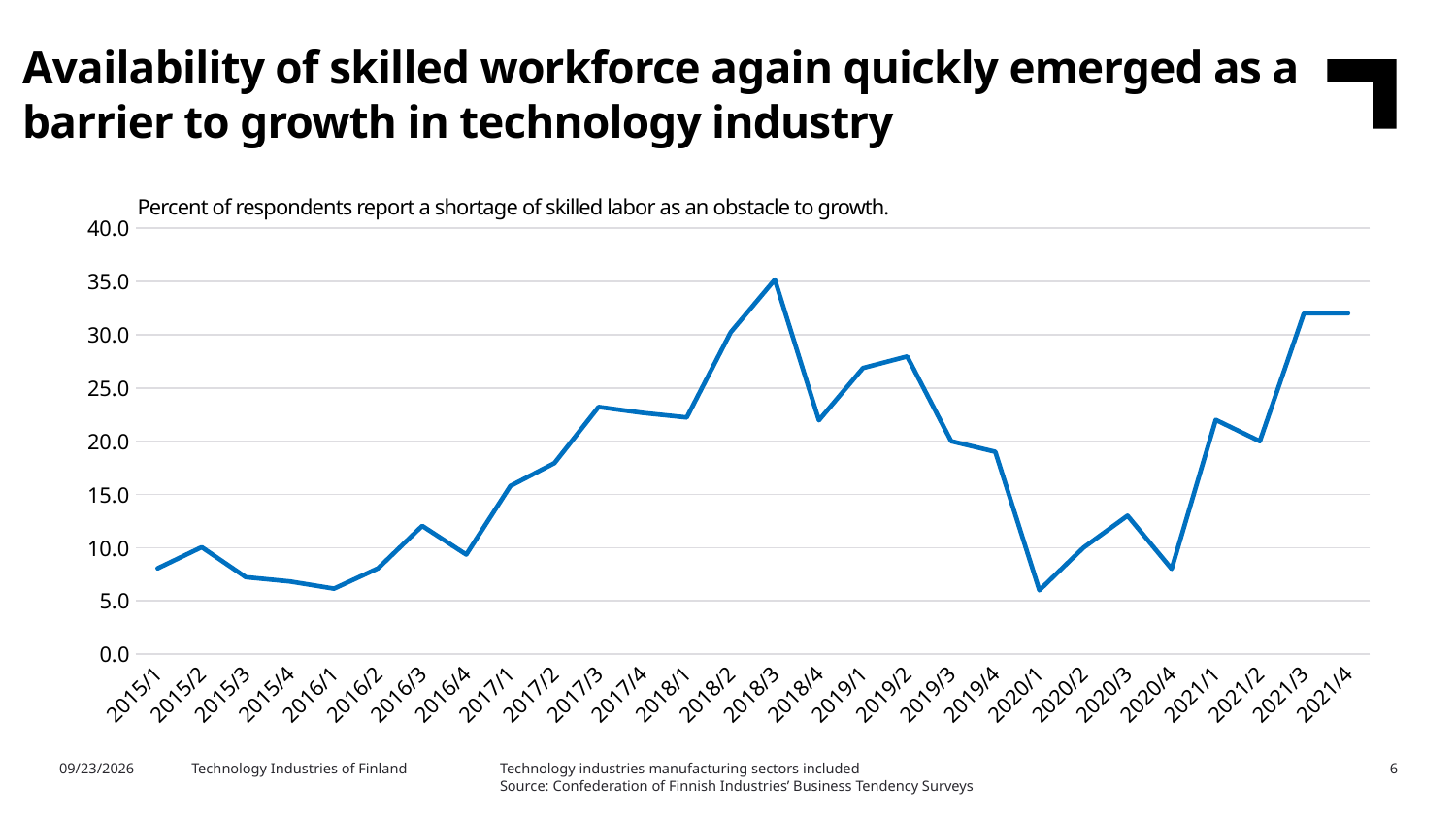
Does the value rise or fall between 2020/1 and 2021/4? Rise What kind of chart is shown on the slide? Line chart Is the value for 2021/4 greater or less than 30? greater How many quarterly data points are plotted on the chart? 28 Is the value for 2020/1 greater or less than 10? less In which quarter does the chart reach its highest value? 2018/3 Which is higher, the value for 2018/3 or the value for 2021/4? 2018/3 What is the subtitle printed above the chart? Percent of respondents report a shortage of skilled labor as an obstacle to growth. Is the value for 2018/3 greater or less than 30? greater Which is higher, the value for 2019/2 or the value for 2019/3? 2019/2